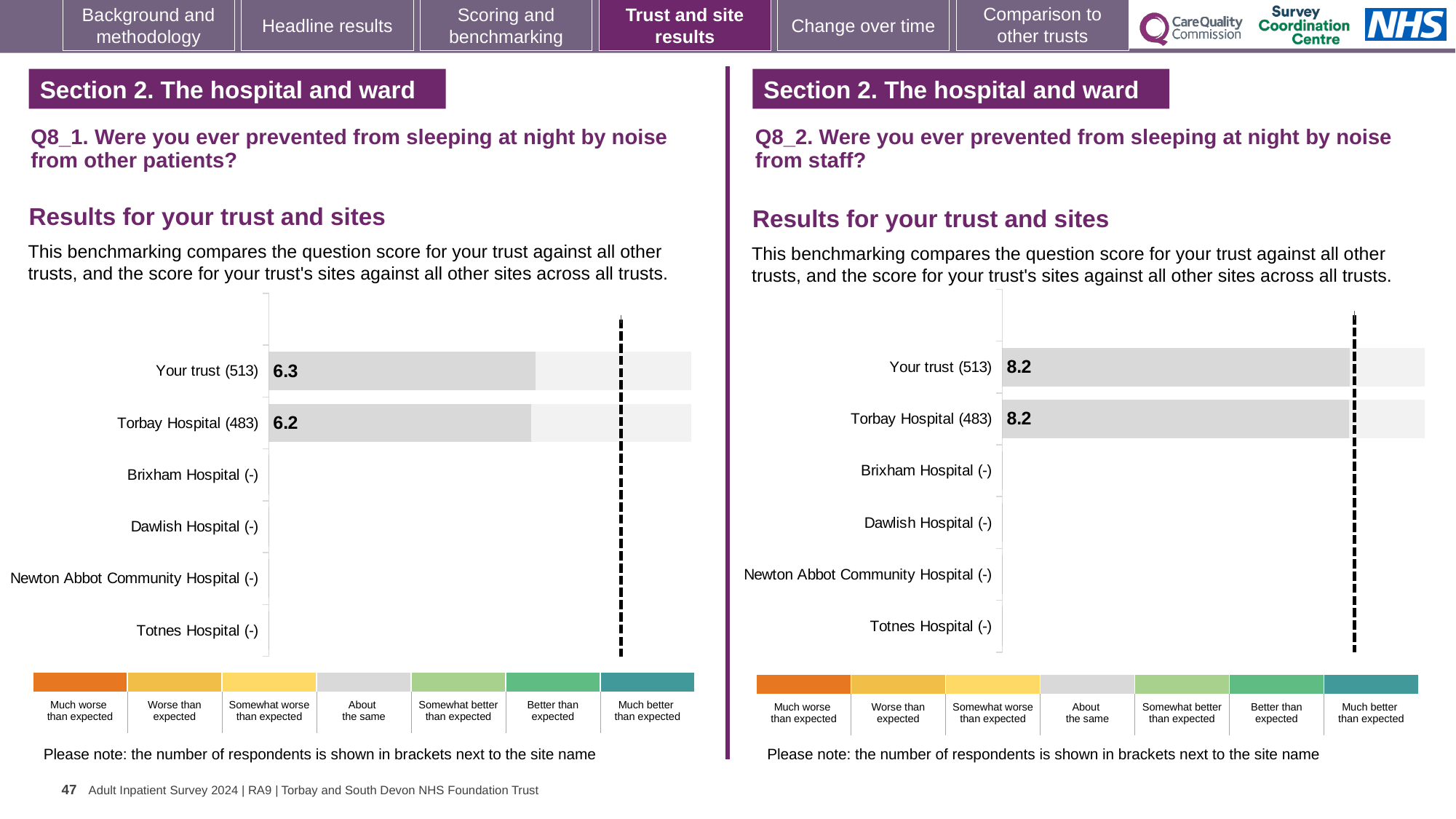
On the Q8_1 chart (left), what is the score for Torbay Hospital (483)? 6.2 On the Q8_2 chart (right), what is the difference between the score for Your trust (513) and Torbay Hospital (483)? 0 On the Q8_1 chart (left), how many benchmark categories are shown in the colour key below the chart? 7 On the Q8_2 chart (right), how many site or trust categories are listed on the vertical axis? 6 On the Q8_1 chart (left), how many categories have a plotted bar with a value? 2 Which chart shows a higher score for Your trust (513): the Q8_1 chart (left) or the Q8_2 chart (right)? Q8_2 chart (right) On the Q8_2 chart (right), what is the score for Your trust (513)? 8.2 On the Q8_1 chart (left), what is the difference between the score for Your trust (513) and Torbay Hospital (483)? 0.1 What kind of chart is the Q8_1 chart (left)? Bar chart On the Q8_1 chart (left), how many site or trust categories are listed on the vertical axis? 6 On the Q8_1 chart (left), what is the score for Your trust (513)? 6.3 On the Q8_2 chart (right), what is the score for Torbay Hospital (483)? 8.2